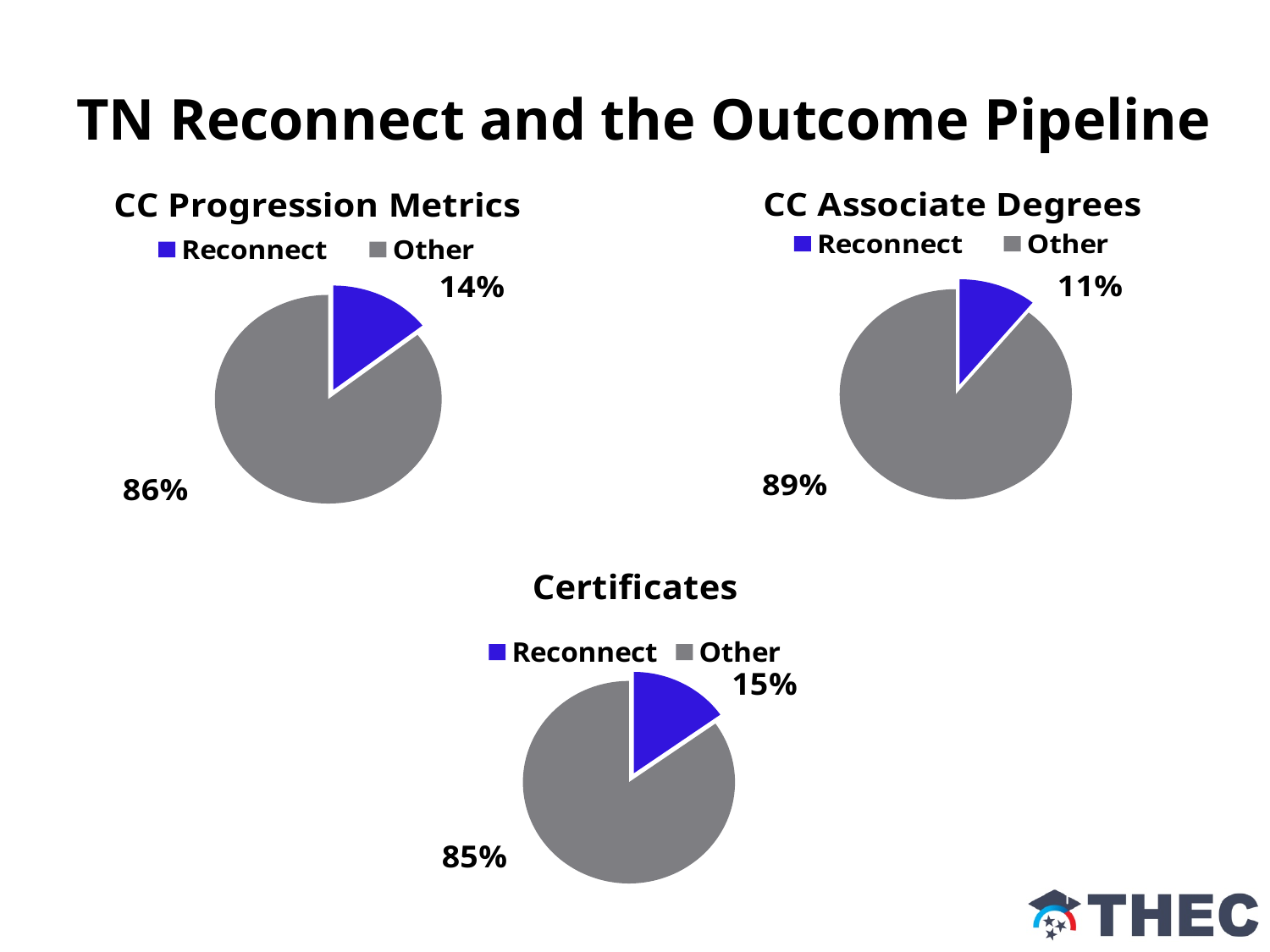
In the 'CC Progression Metrics' chart, what is the difference between the Other and Reconnect shares? 72% In the 'CC Progression Metrics' chart, what share of the pie is Other? 86% In the 'Certificates' chart, what share of the pie is Other? 85% What kind of chart is the 'Certificates' chart? Pie chart How many slices does the 'CC Associate Degrees' pie chart have? 2 In the 'Certificates' chart, which slice is the largest? Other In the 'CC Associate Degrees' chart, what share of the pie is Other? 89% In the 'CC Associate Degrees' chart, which slice is the smallest? Reconnect In the 'CC Progression Metrics' chart, what colour is the Reconnect slice? Blue